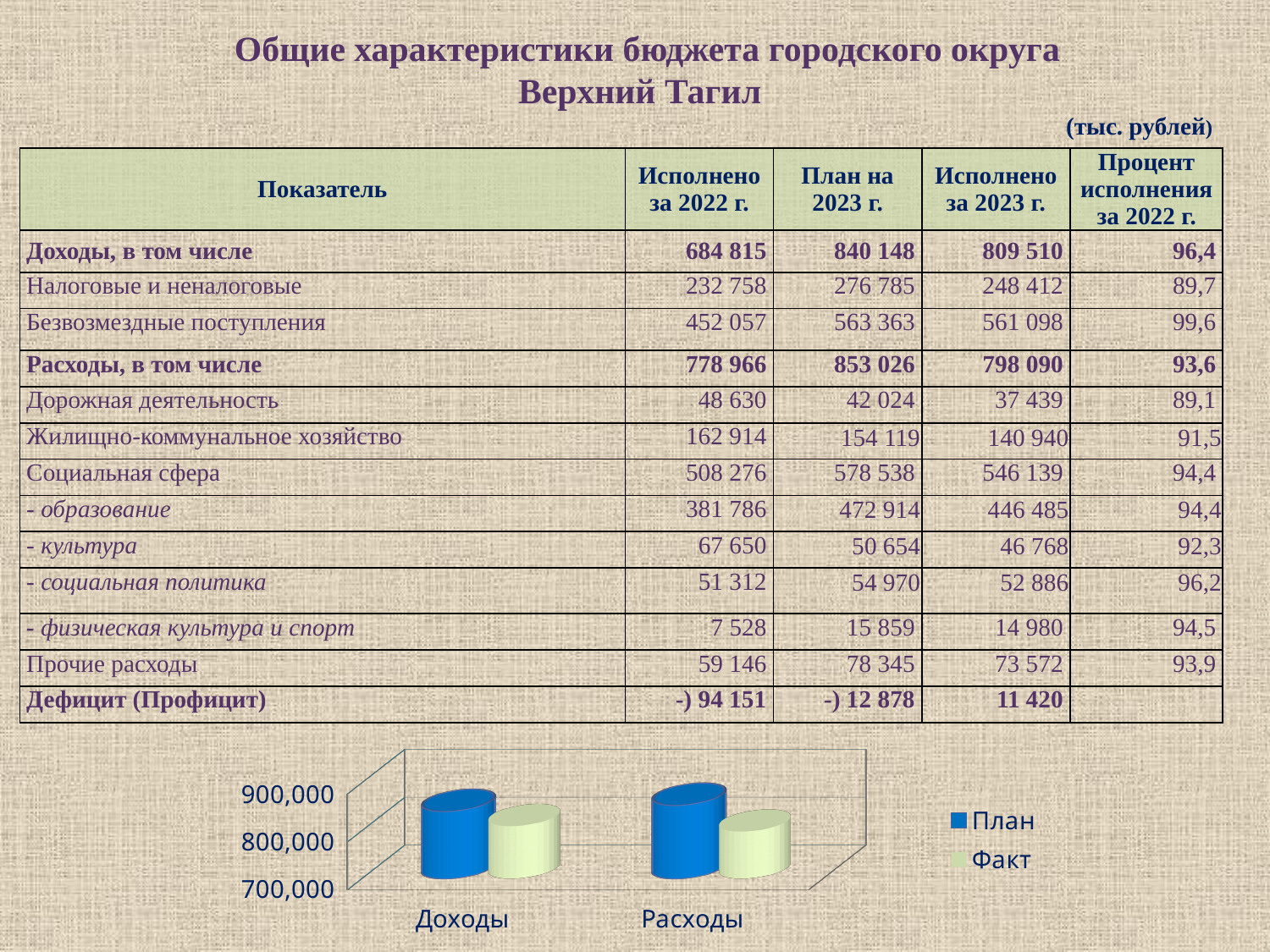
What are the two category labels on the x axis of the chart? Доходы and Расходы How many categories are shown on the x axis of the chart? 2 Is the План value for Доходы greater or less than 800,000? greater How many series does the chart legend list? 2 Is the Факт value for Расходы greater or less than 900,000? less What are the two series named in the chart legend? План and Факт What is the highest value shown on the vertical axis of the chart? 900,000 Is the План value for Расходы greater or less than 800,000? greater For Расходы, which is larger in the chart: План or Факт? План What kind of chart is shown at the bottom of the slide? bar chart For Доходы, which is larger in the chart: План or Факт? План Which colour represents the План series in the chart? blue